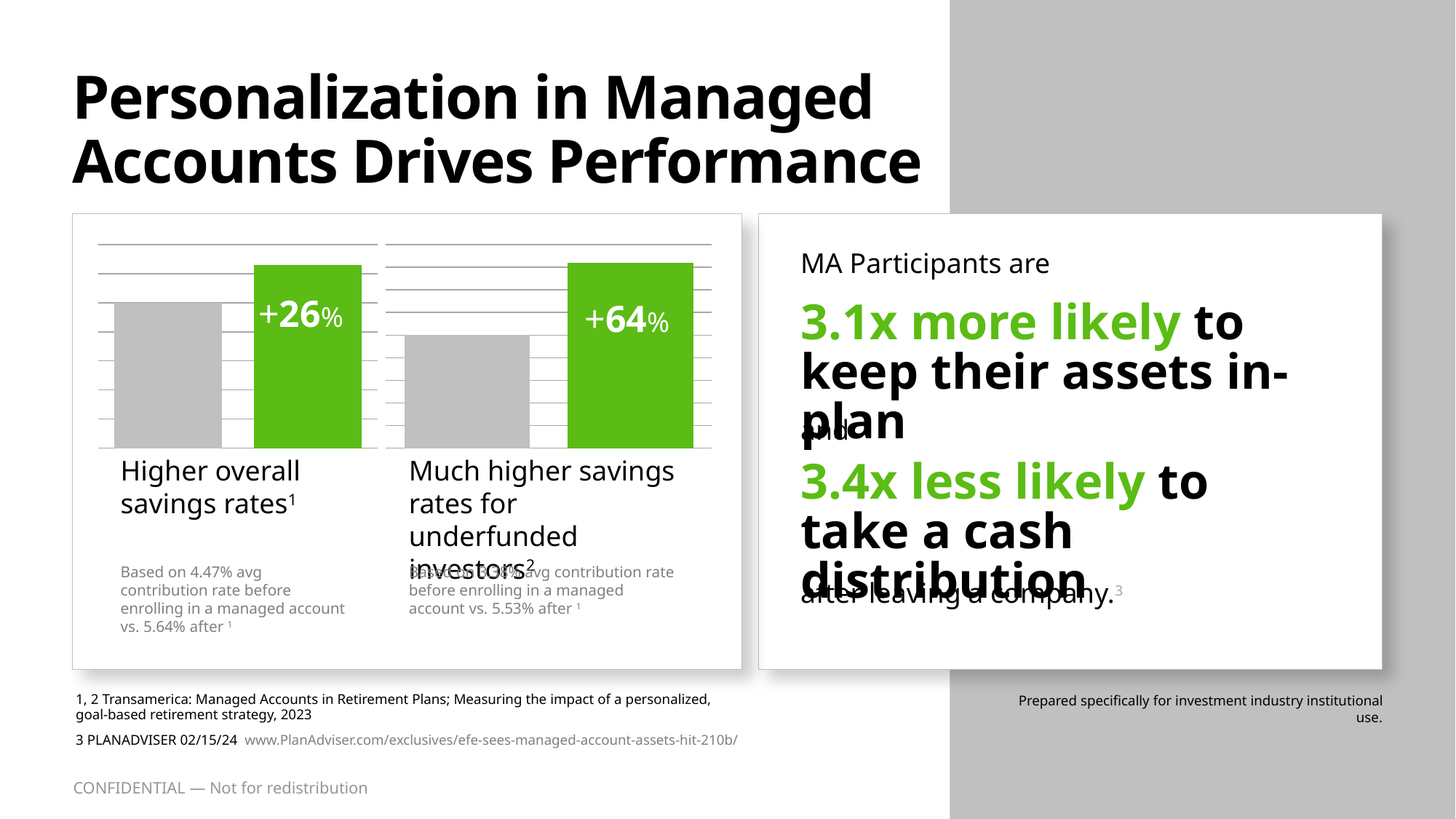
In the left chart (Higher overall savings rates), which bar is taller, the gray bar or the green bar? the green bar What is the difference between the percentage increases printed on the two charts (+64% and +26%)? 38 percentage points What is the caption under the right chart? Much higher savings rates for underfunded investors How many bar charts are shown on the slide? 2 How many bars are shown in the right chart (Much higher savings rates for underfunded investors)? 2 In the left chart (Higher overall savings rates), what colour is the bar that carries the +26% label? green What type of chart is used in the left panel (Higher overall savings rates)? bar chart In the right chart (Much higher savings rates for underfunded investors), which bar is taller, the gray bar or the green bar? the green bar Which of the two charts shows the larger percentage increase, the left one (Higher overall savings rates) or the right one (Much higher savings rates for underfunded investors)? the right one (+64%) In the right chart (Much higher savings rates for underfunded investors), what percentage increase is printed on the green bar? +64% In the left chart (Higher overall savings rates), what percentage increase is printed on the green bar? +26%